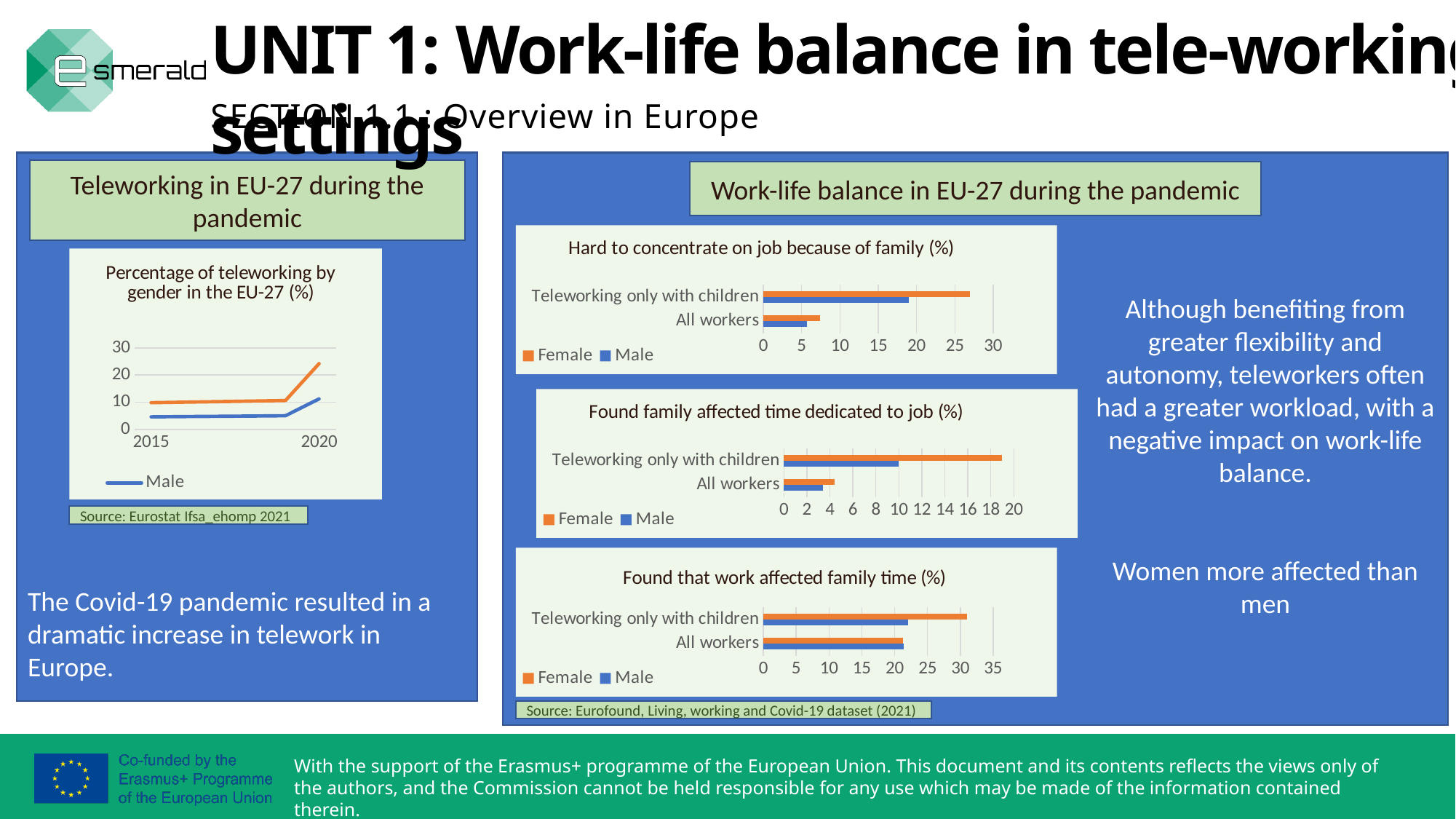
In the chart 'Percentage of teleworking by gender in the EU-27 (%)', do the values rise or fall from 2015 to 2020? rise In the chart 'Percentage of teleworking by gender in the EU-27 (%)', which years are shown on the x axis? 2015 and 2020 What kind of chart is 'Hard to concentrate on job because of family (%)'? bar chart In the chart 'Hard to concentrate on job because of family (%)', which is larger for 'Teleworking only with children', Female or Male? Female In the chart 'Percentage of teleworking by gender in the EU-27 (%)', is the Male value for 2015 greater or less than 10? less In the chart 'Found that work affected family time (%)', is the Female value for 'Teleworking only with children' greater or less than 25? greater In the chart 'Found that work affected family time (%)', which is larger for 'Teleworking only with children', Female or Male? Female In the chart 'Found family affected time dedicated to job (%)', how many categories are shown? 2 In the chart 'Found family affected time dedicated to job (%)', is the Female value for 'Teleworking only with children' greater or less than 16? greater In the chart 'Hard to concentrate on job because of family (%)', how many series does the legend list? 2 What kind of chart is 'Percentage of teleworking by gender in the EU-27 (%)'? line chart